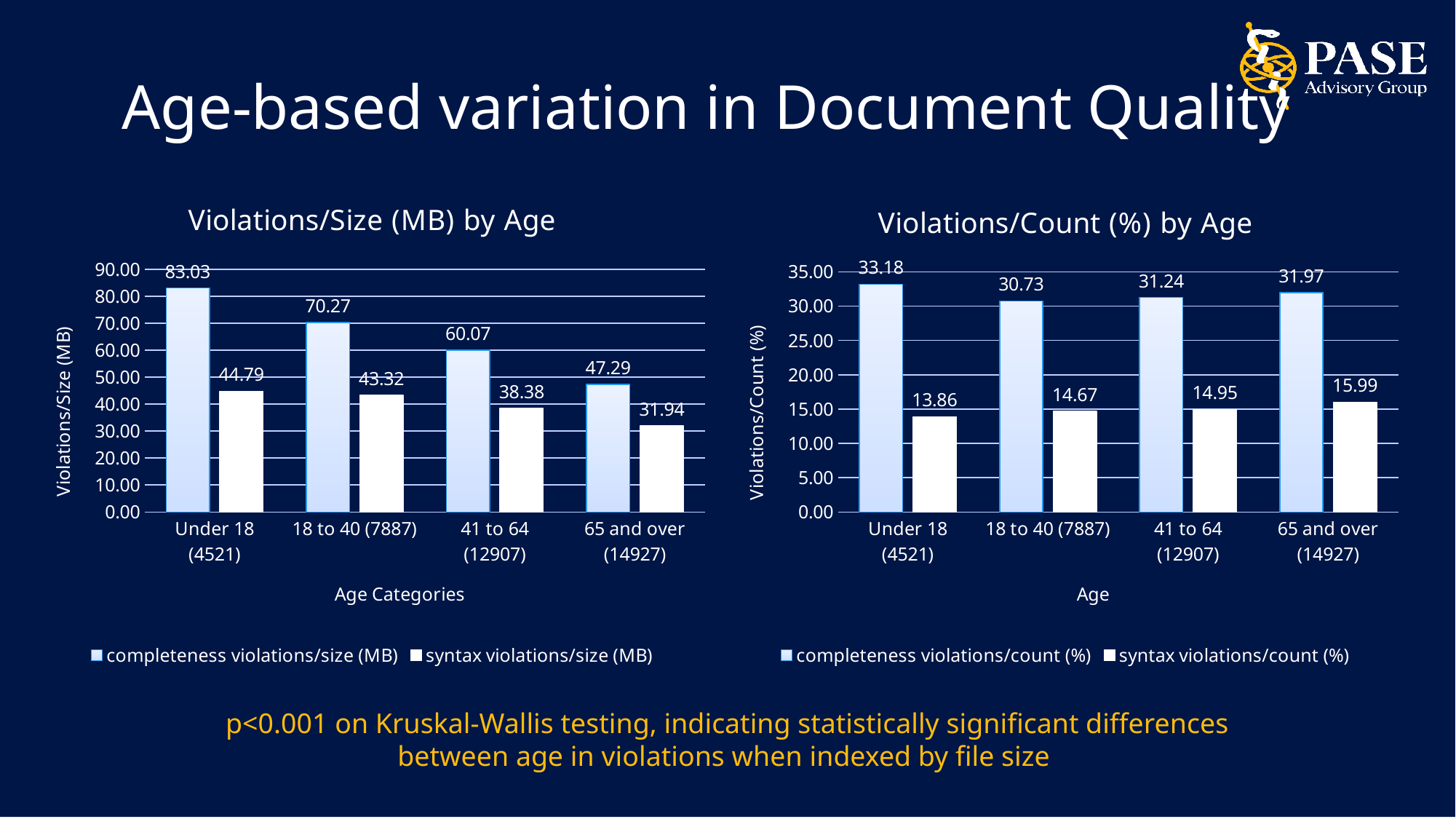
In the 'Violations/Count (%) by Age' chart, which age category has the highest completeness violations/count (%)? Under 18 (4521) What kind of chart is the 'Violations/Size (MB) by Age' chart? bar chart In the 'Violations/Size (MB) by Age' chart, what is the syntax violations/size (MB) value for 41 to 64 (12907)? 38.38 In the 'Violations/Count (%) by Age' chart, do syntax violations/count (%) rise or fall across the age categories from left to right? rise In the 'Violations/Count (%) by Age' chart, which is larger: the completeness violations/count (%) for 18 to 40 (7887) or for 41 to 64 (12907)? 41 to 64 (12907) How many age categories are shown in the 'Violations/Size (MB) by Age' chart? 4 In the 'Violations/Size (MB) by Age' chart, what is the difference between the completeness violations/size (MB) for Under 18 (4521) and for 65 and over (14927)? 35.74 How many series does the legend of the 'Violations/Count (%) by Age' chart list? 2 In the 'Violations/Count (%) by Age' chart, what is the syntax violations/count (%) value for 65 and over (14927)? 15.99 In the 'Violations/Size (MB) by Age' chart, do completeness violations/size (MB) rise or fall across the age categories from left to right? fall In the 'Violations/Size (MB) by Age' chart, which age category has the lowest syntax violations/size (MB)? 65 and over (14927) In the 'Violations/Size (MB) by Age' chart, what is the completeness violations/size (MB) value for Under 18 (4521)? 83.03